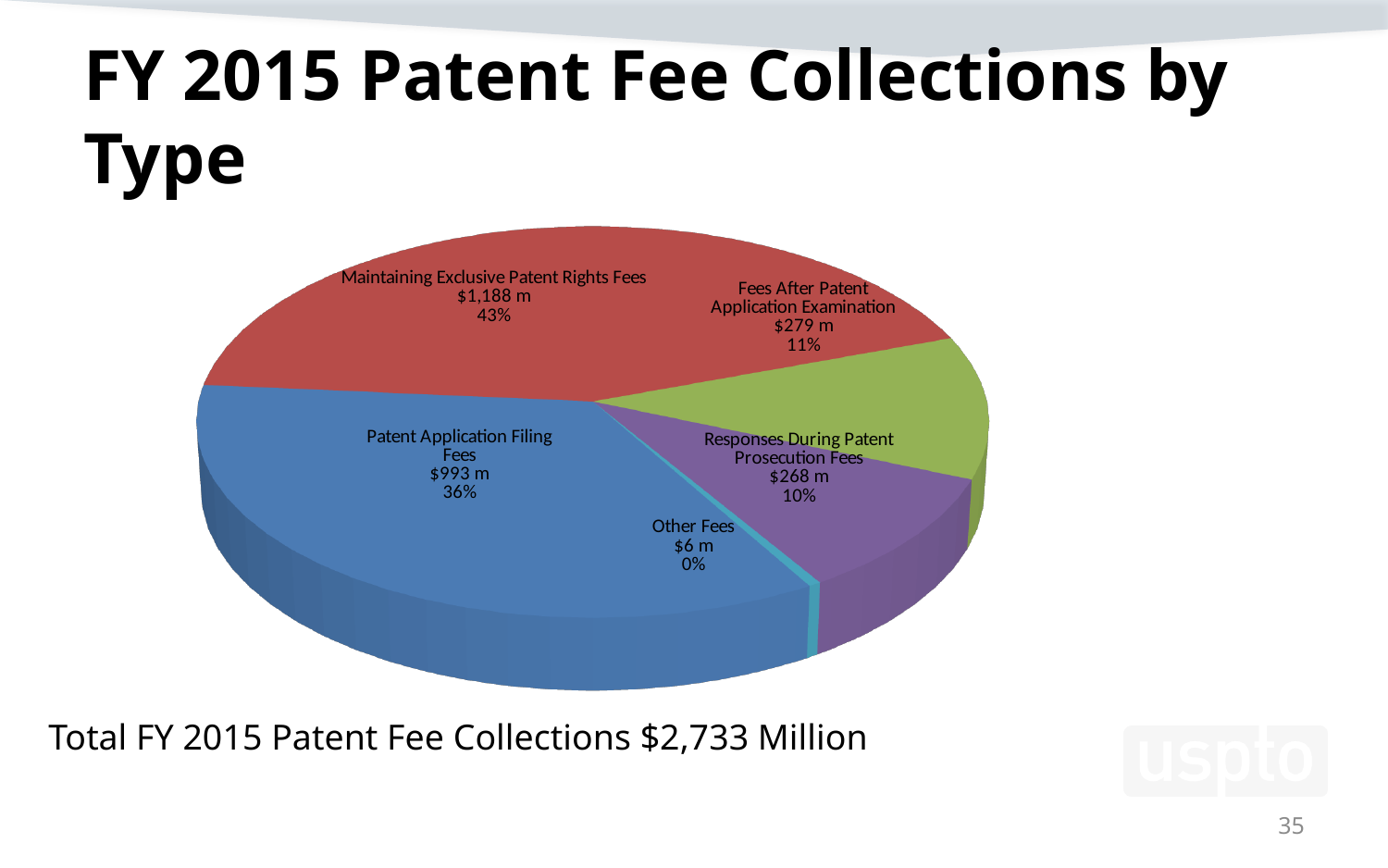
What is the value for Responses During Patent Prosecution Fees? $268 m What share of the pie is Patent Application Filing Fees? 36% What is the value for Patent Application Filing Fees? $993 m What share of the pie is Fees After Patent Application Examination? 11% What is the value for Other Fees? $6 m Which fee type has the largest share of collections? Maintaining Exclusive Patent Rights Fees How many slices does the pie chart have? 5 What is the title of the chart on the slide? FY 2015 Patent Fee Collections by Type What type of chart is shown on the slide? Pie chart What is the difference between Maintaining Exclusive Patent Rights Fees and Patent Application Filing Fees? $195 m What is the value for Maintaining Exclusive Patent Rights Fees? $1,188 m Which fee type has the smallest share of collections? Other Fees